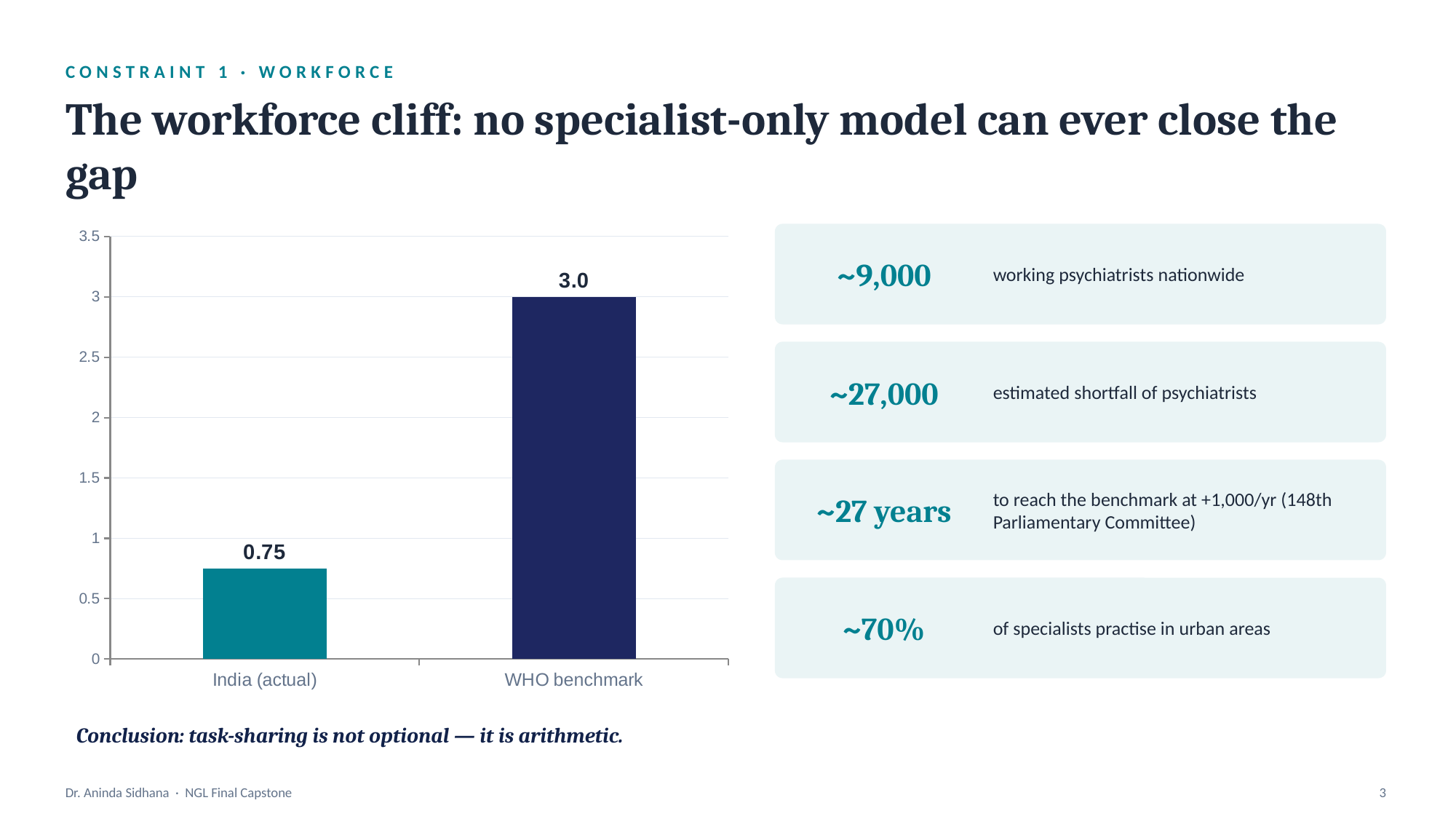
What is the value for WHO benchmark? 3.0 What is the difference between the WHO benchmark value and the India (actual) value? 2.25 What is the value for India (actual)? 0.75 Is the value for India (actual) greater or less than 1? less What kind of chart is shown on the slide? bar chart What is the highest tick value shown on the y axis of the chart? 3.5 What colour is the bar for India (actual)? teal Is the value for WHO benchmark greater or less than 2.5? greater Which category has the highest value? WHO benchmark Which category has the lowest value? India (actual) Which is larger, the value for India (actual) or the value for WHO benchmark? WHO benchmark How many categories are shown on the x axis of the chart? 2